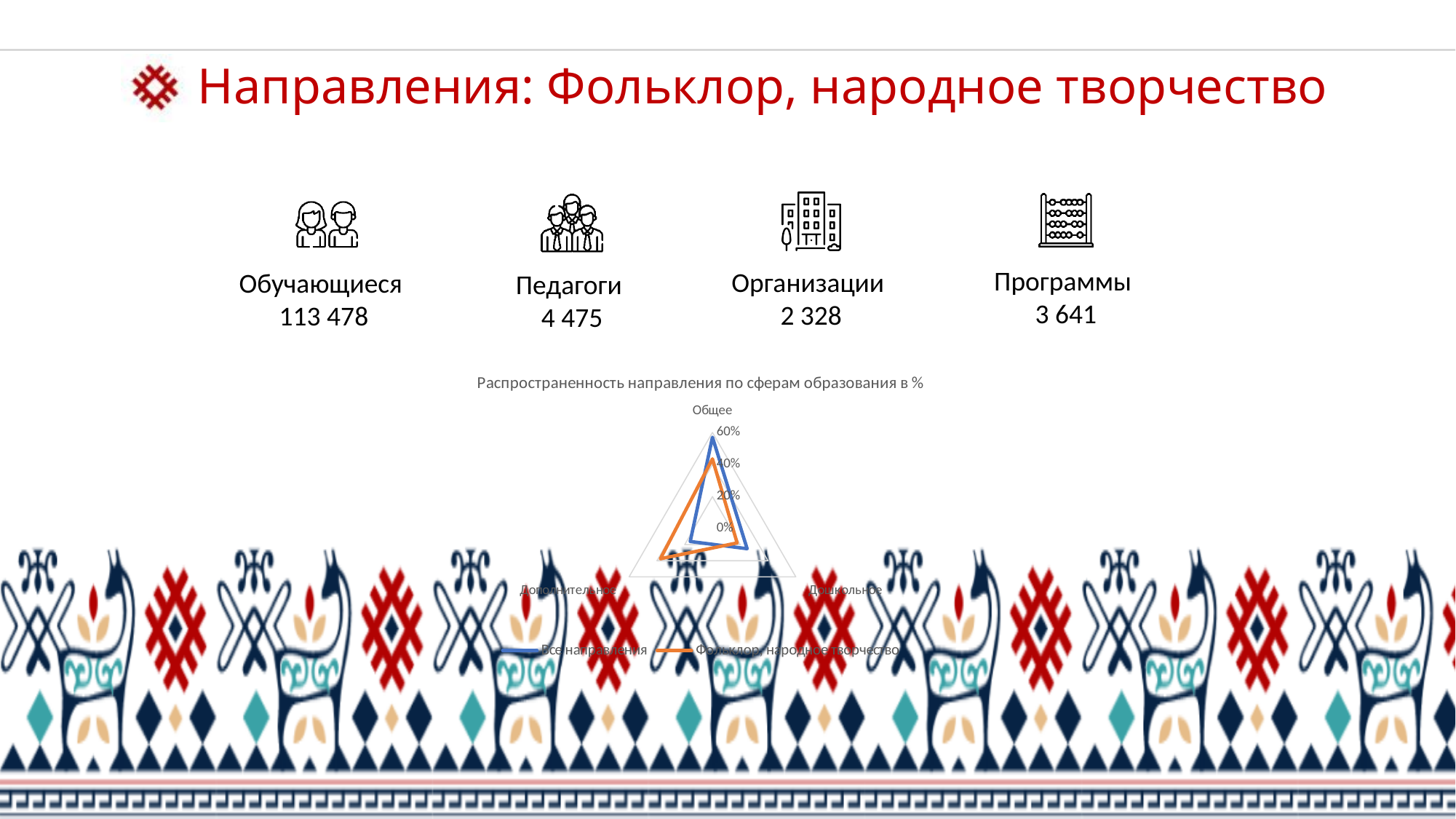
What kind of chart is shown on the slide? Radar chart How many series does the chart legend list? 2 For the category Общее, which series has the larger value: Все направления or Фольклор, народное творчество? Все направления Is the value for Общее in the series Все направления greater or less than 40%? greater Is the value for Общее in the series Фольклор, народное творчество greater or less than 60%? less How many categories (axes) does the radar chart have? 3 For the category Дополнительное, which series has the larger value: Все направления or Фольклор, народное творчество? Фольклор, народное творчество Which series is drawn in orange in the chart? Фольклор, народное творчество What is the title of the chart? Распространенность направления по сферам образования в %